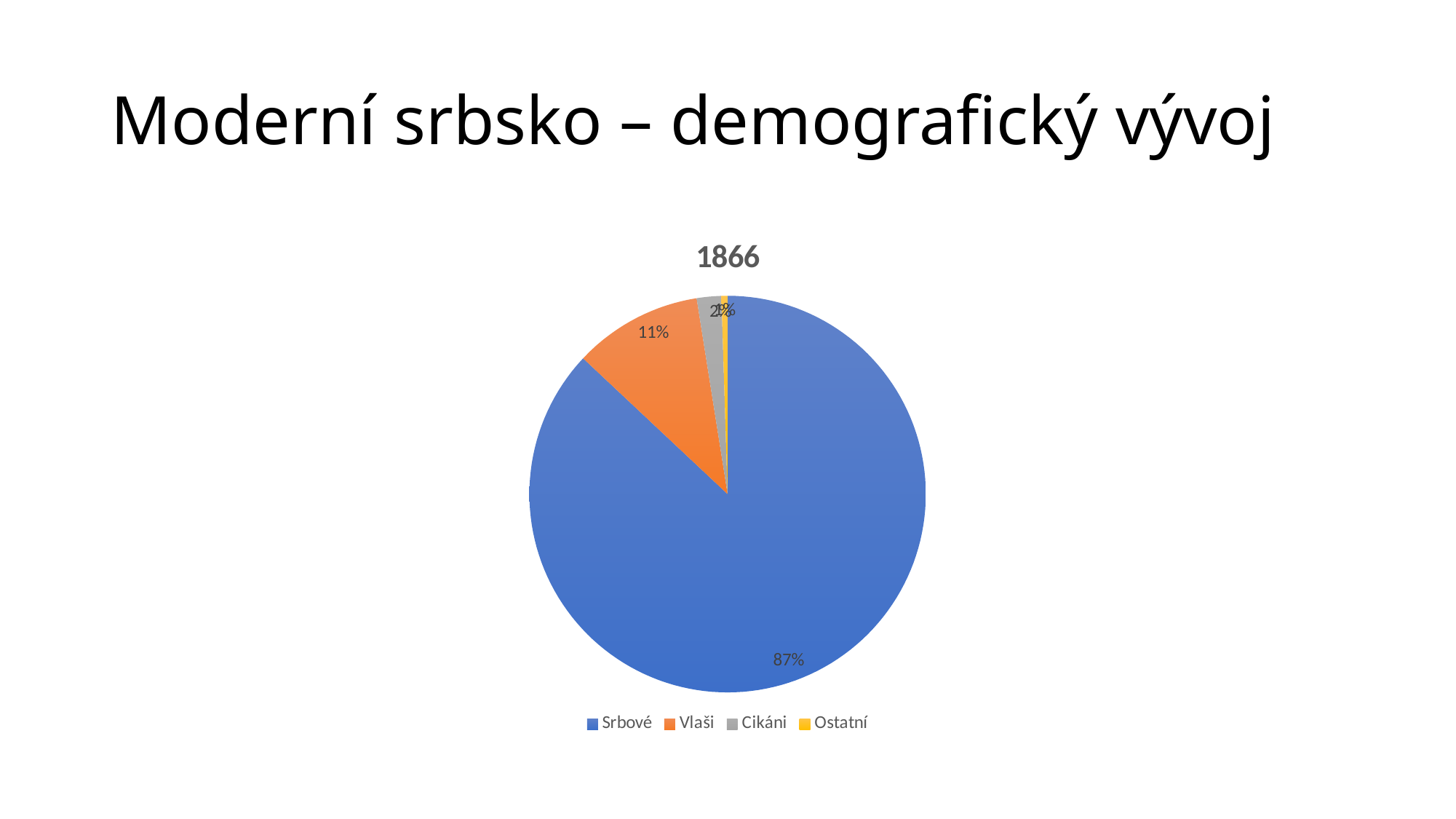
What is the difference in percentage points between Vlaši and Cikáni? 9 What is the title of the chart? 1866 What share of the pie does Srbové hold? 87% What kind of chart is shown on the slide? Pie chart What percentage is shown for Vlaši? 11% What percentage is shown for Cikáni? 2% Which category has the smallest slice of the pie? Ostatní Which is larger, the slice for Vlaši or the slice for Cikáni? Vlaši How many categories does the pie chart show? 4 What colour is the Srbové slice? Blue What is the difference in percentage points between Srbové and Vlaši? 76 Which category has the largest slice of the pie? Srbové